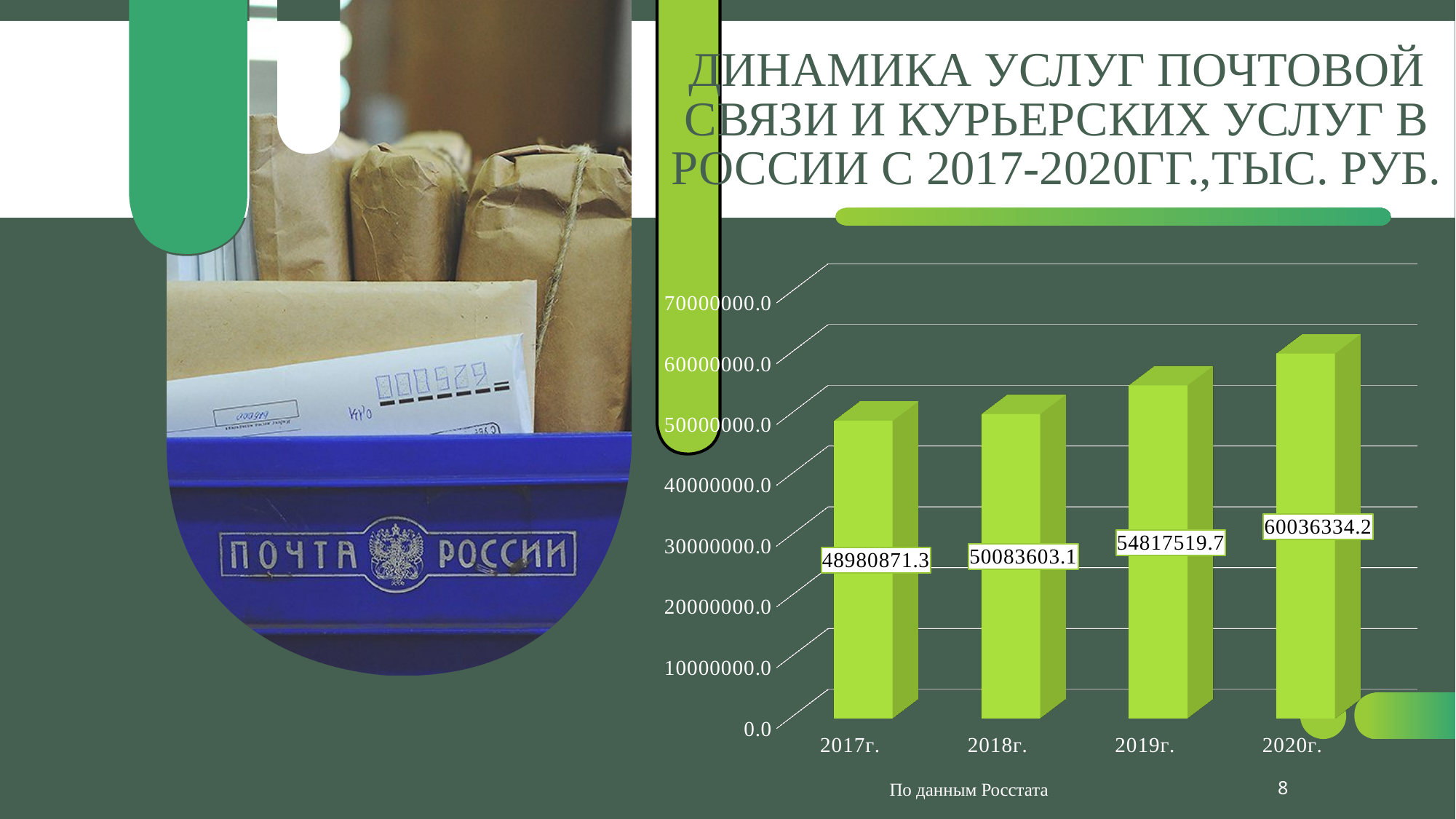
Which year has the highest value? 2020г. Which is larger, the value for 2018г. or the value for 2019г.? 2019г. What is the difference between the values for 2020г. and 2017г.? 11055462.9 Which year has the lowest value? 2017г. What is the value for 2017г.? 48980871.3 Is the value for 2020г. greater or less than 50000000.0? greater What is the value for 2020г.? 60036334.2 What kind of chart is shown on the slide? bar chart What is the value for 2019г.? 54817519.7 How many years are shown on the x axis? 4 Do the values rise or fall from 2017г. to 2020г.? rise What is the difference between the values for 2019г. and 2018г.? 4733916.6